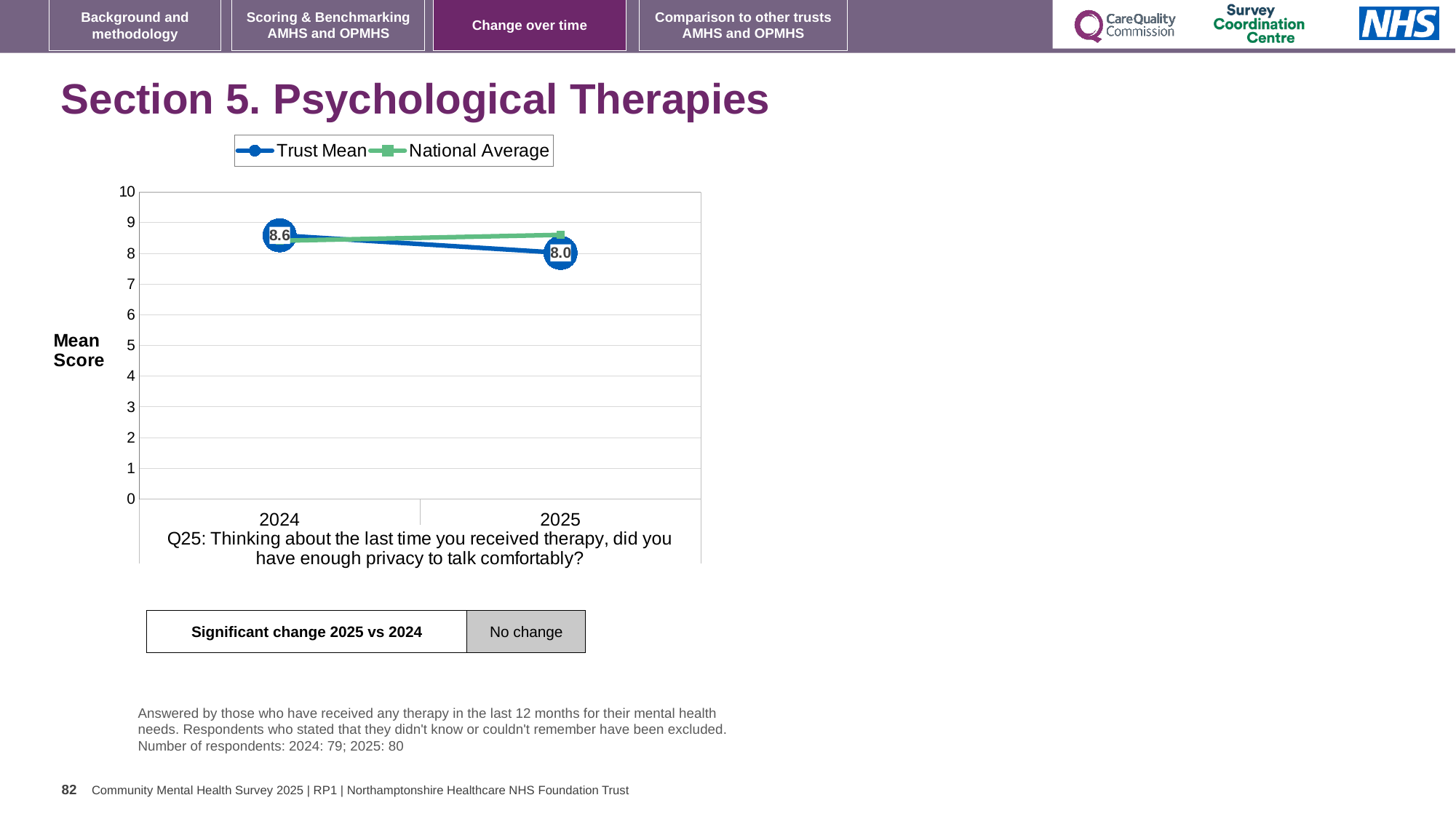
What is the label on the y axis of the chart? Mean Score Which year has the higher Trust Mean score, 2024 or 2025? 2024 By how much did the Trust Mean score change from 2024 to 2025? 0.6 What kind of chart is shown on the slide? line chart How many years are plotted on the x axis? 2 Is the National Average value for 2025 greater or less than 8? greater How many series does the legend list? 2 Does the Trust Mean line rise or fall from 2024 to 2025? fall What is the Trust Mean score for 2024? 8.6 What are the two series named in the legend? Trust Mean and National Average In 2025, which series is higher, Trust Mean or National Average? National Average What is the Trust Mean score for 2025? 8.0